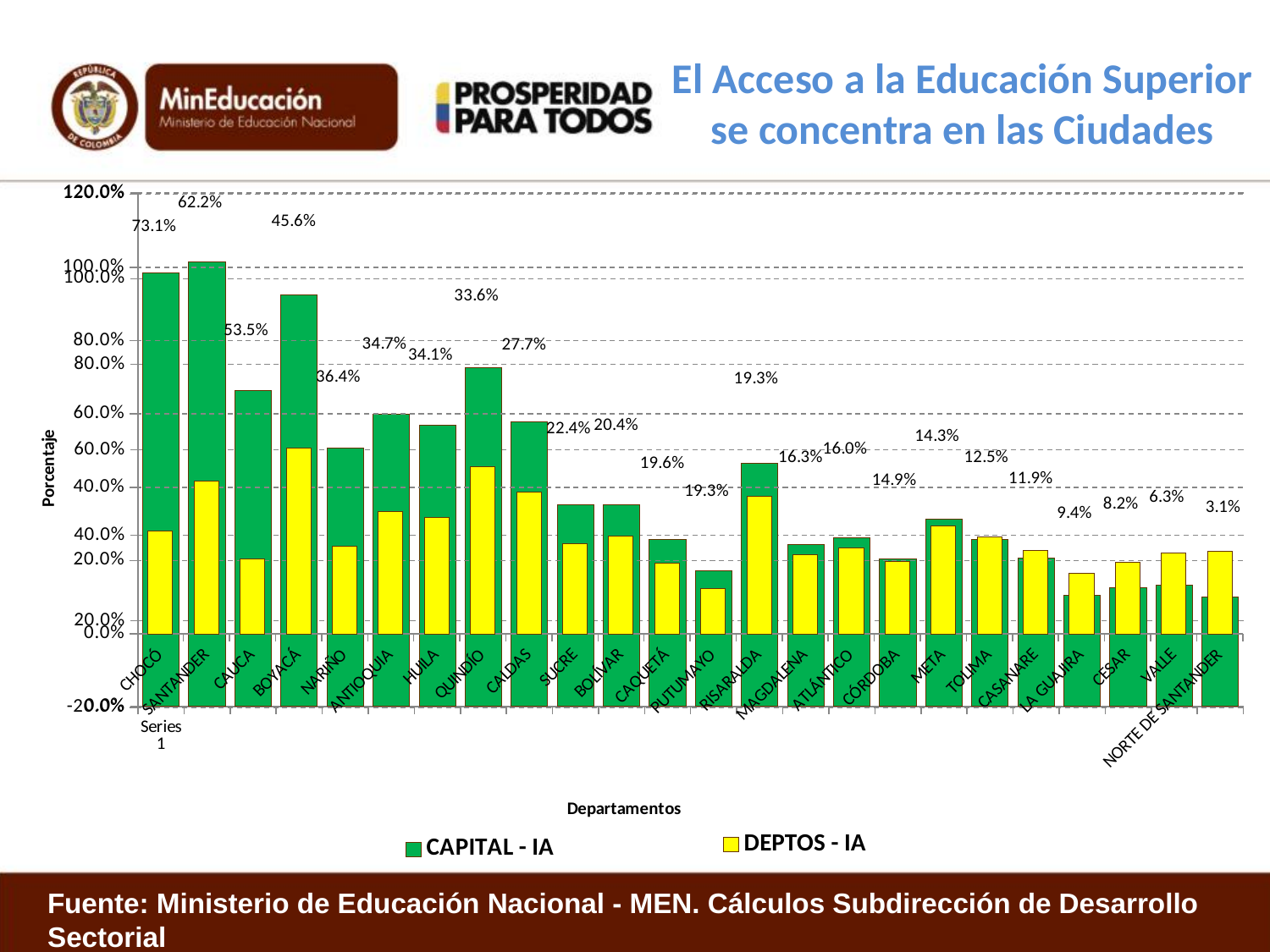
Which is larger, the CAPITAL - IA bar for Boyacá or the CAPITAL - IA bar for Nariño? Boyacá How many series does the legend list? 2 Which is larger, the DEPTOS - IA bar for Santander or the DEPTOS - IA bar for Cauca? Santander What are the two series named in the legend? CAPITAL - IA and DEPTOS - IA How many departments are shown along the x axis? 24 What kind of chart is shown on the slide? bar chart What is the title of the x axis? Departamentos Which department has the highest DEPTOS - IA (yellow) bar? Boyacá Which is larger, the CAPITAL - IA bar for Chocó or the CAPITAL - IA bar for Cauca? Chocó Do the CAPITAL - IA values generally rise or fall from left to right along the x axis? fall